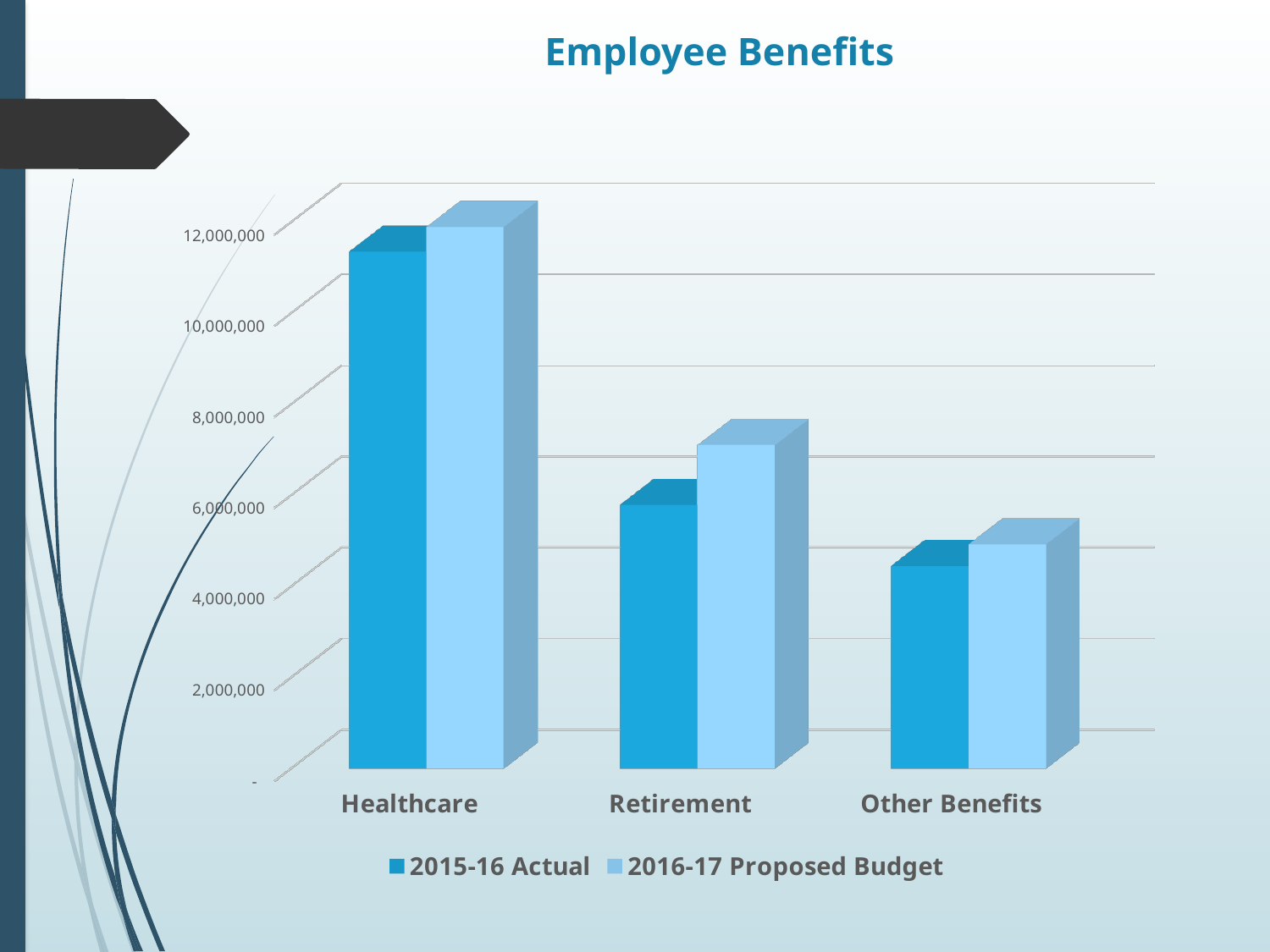
What kind of chart is shown on the slide? Bar chart Is the 2016-17 Proposed Budget value for Retirement greater or less than 8,000,000? less How many categories are shown on the x axis of the chart? 3 What are the two series named in the chart's legend? 2015-16 Actual and 2016-17 Proposed Budget What is the title of the chart on the slide? Employee Benefits For Healthcare, which series has the larger value: 2015-16 Actual or 2016-17 Proposed Budget? 2016-17 Proposed Budget Which category has the lowest value for the 2016-17 Proposed Budget series? Other Benefits Is the 2015-16 Actual value for Other Benefits greater or less than 4,000,000? greater For Retirement, which series has the larger value: 2015-16 Actual or 2016-17 Proposed Budget? 2016-17 Proposed Budget Is the 2015-16 Actual value for Healthcare greater or less than 10,000,000? greater How many series does the chart's legend list? 2 Which category has the highest value for the 2015-16 Actual series? Healthcare